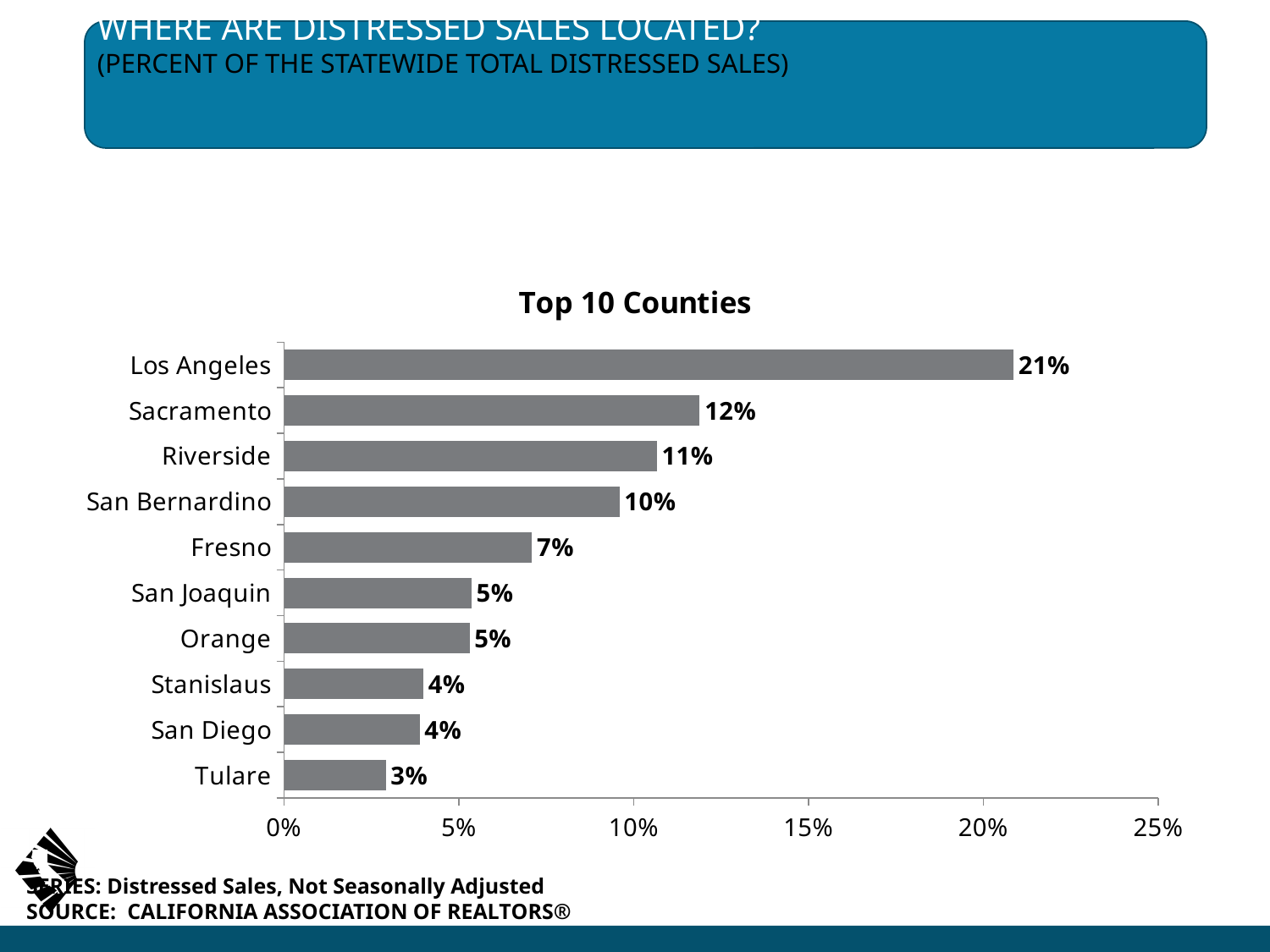
Which is larger, the value for Sacramento or the value for Fresno? Sacramento What kind of chart is shown on the slide? bar chart What is the value shown for San Bernardino? 10% How many counties are shown in the chart? 10 Is the value for Riverside greater or less than 10%? greater What is the difference between the values for Los Angeles and Sacramento? 9% What is the difference between the values for Riverside and Tulare? 8% What is the value shown for Fresno? 7% What percent of statewide distressed sales is Los Angeles? 21% Which county has the lowest share of distressed sales? Tulare What is the title of the chart? Top 10 Counties Which county has the highest share of distressed sales? Los Angeles